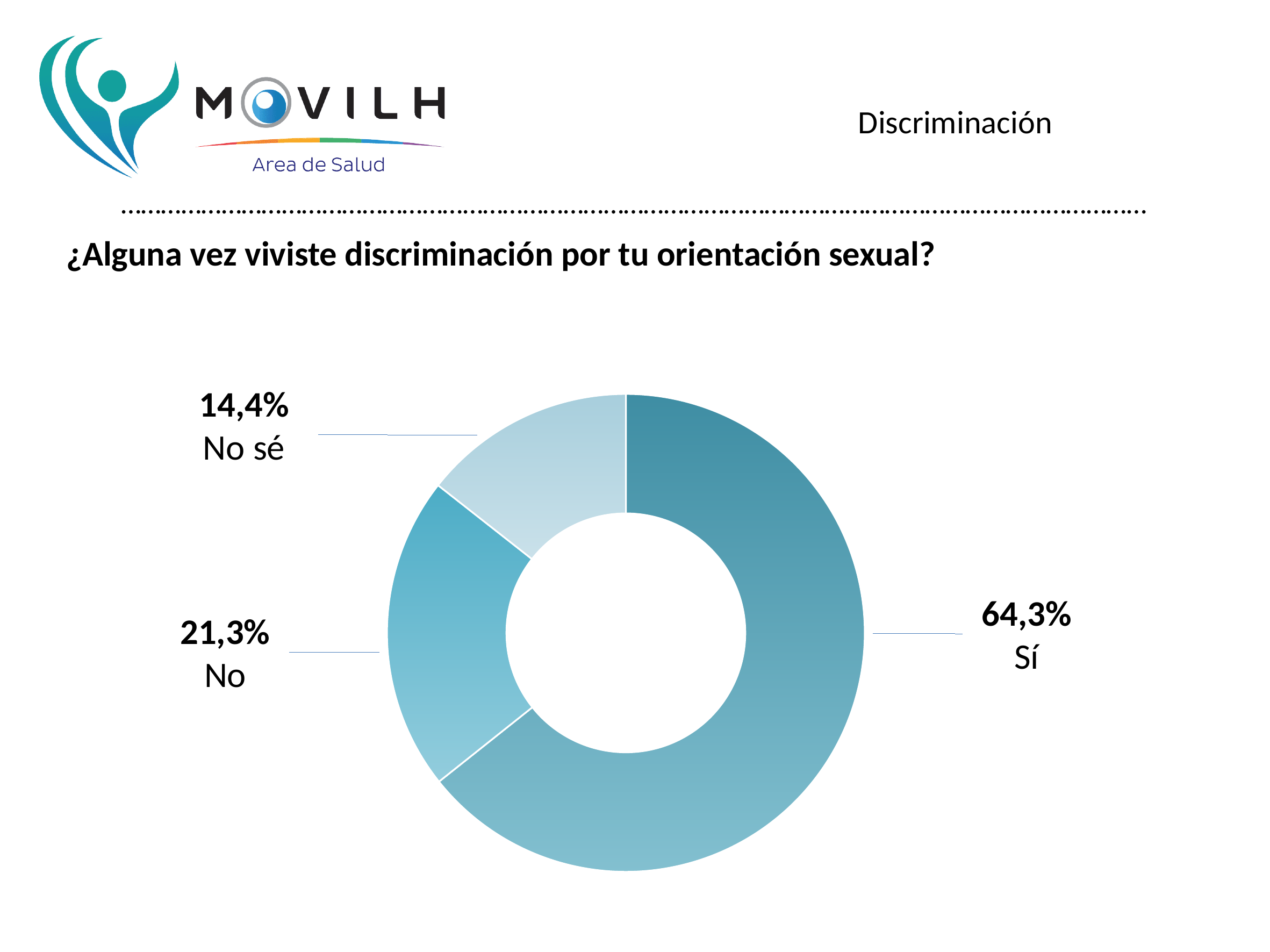
Which response has the largest share of the chart? Sí What question does the chart answer, as written above it? ¿Alguna vez viviste discriminación por tu orientación sexual? What percentage of respondents answered "Sí"? 64,3% How many response categories are shown in the chart? 3 What is the difference in percentage points between "Sí" and "No"? 43 percentage points What percentage of respondents answered "No sé"? 14,4% What kind of chart is shown on the slide? Doughnut (pie) chart Which slice is shown in the lightest shade of blue? No sé Which is larger, the share for "No" or the share for "No sé"? No What percentage of respondents answered "No"? 21,3% Which response has the smallest share of the chart? No sé What is the difference in percentage points between "No" and "No sé"? 6,9 percentage points